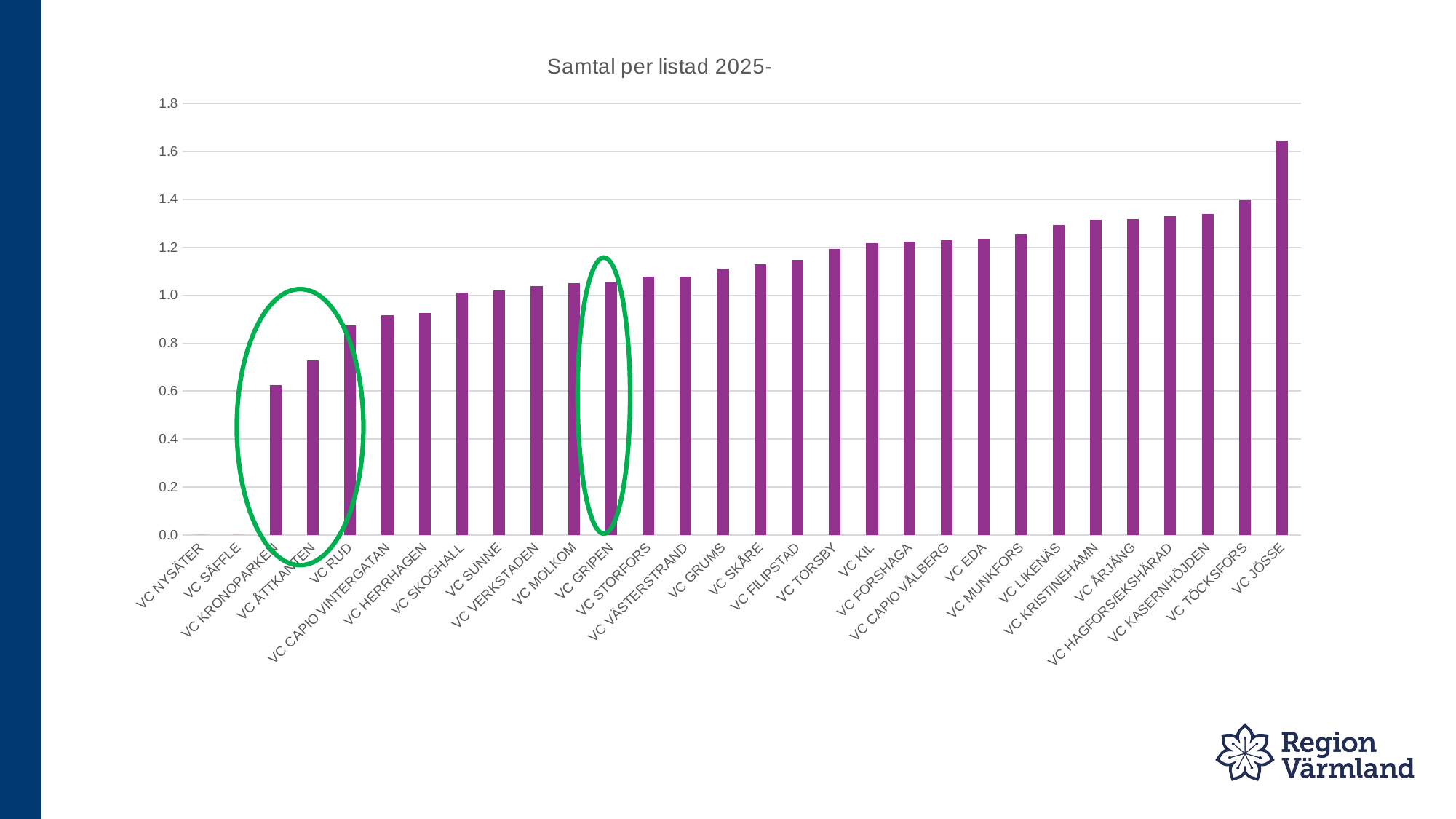
Which category has the tallest bar in the chart? VC JÖSSE Is the value for VC RUD greater or less than 0.8? greater How many categories are shown on the x axis of the chart? 30 Which category has the shortest visible bar in the chart? VC KRONOPARKEN Is the value for VC HERRHAGEN greater or less than 1.0? less Do the bar values generally rise or fall from left to right along the x axis? rise What kind of chart is shown on the slide? bar chart Is the value for VC MUNKFORS greater or less than 1.2? greater Which has the larger value, VC RUD or VC ÅTTKANTEN? VC RUD What is the title of the chart? Samtal per listad 2025-